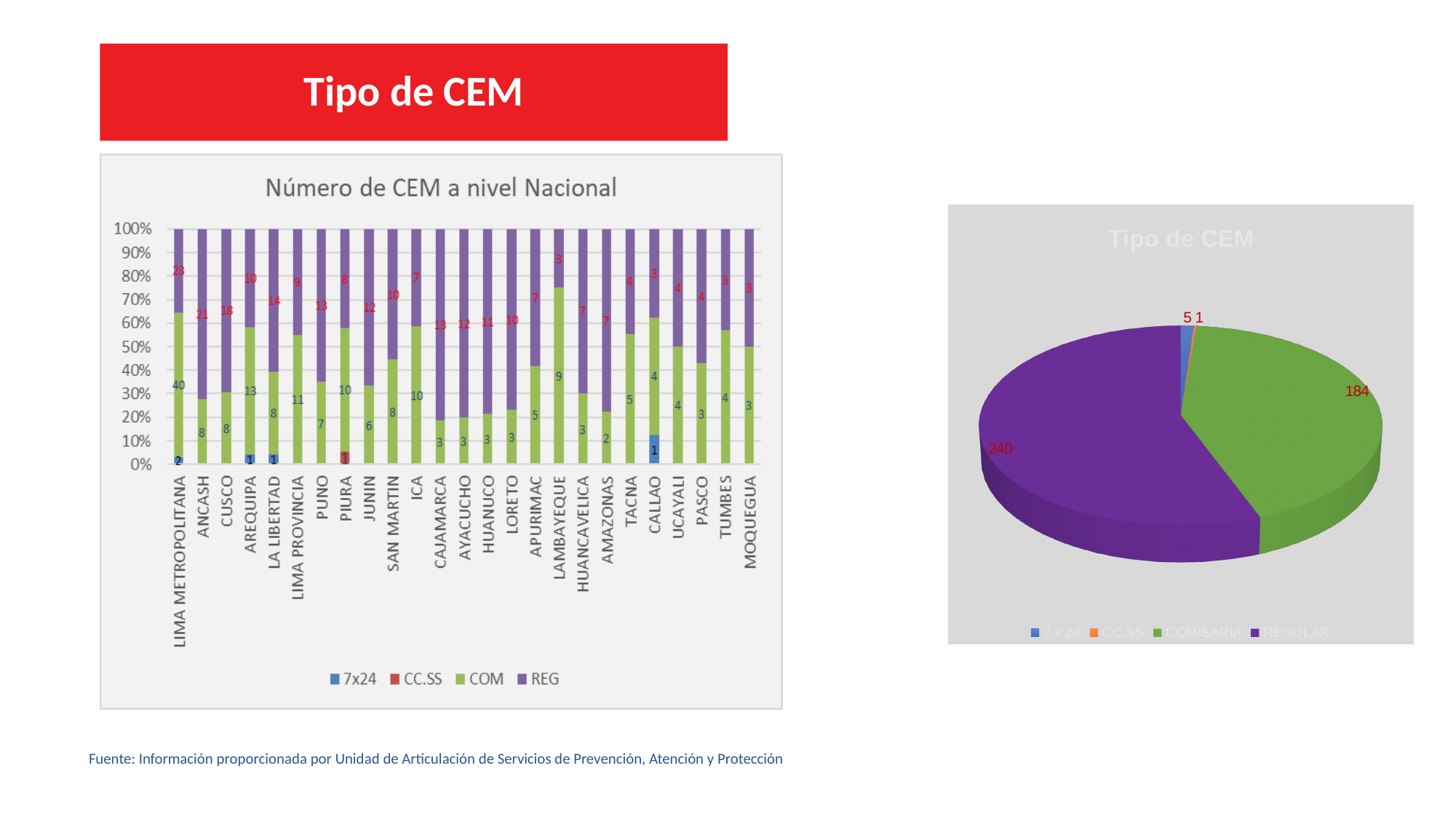
What kind of chart is the chart titled 'Tipo de CEM' on the right of the slide? Pie chart In the chart titled 'Número de CEM a nivel Nacional', how many categories are shown on the x axis? 25 In the chart titled 'Número de CEM a nivel Nacional', what is the REG value for Ancash? 21 In the chart titled 'Número de CEM a nivel Nacional', which category has the highest REG value? Lima Metropolitana In the chart titled 'Número de CEM a nivel Nacional', how many series does the legend list? 4 In the chart titled 'Número de CEM a nivel Nacional', what is the COM value for Lima Metropolitana? 40 In the chart titled 'Número de CEM a nivel Nacional', what is the difference between the REG value for Lima Metropolitana and the REG value for Ancash? 2 In the pie chart titled 'Tipo de CEM', which slice is the smallest? CC.SS In the chart titled 'Número de CEM a nivel Nacional', which is larger for Cusco, the COM value or the REG value? REG In the chart titled 'Número de CEM a nivel Nacional', what is the total of the stacked bar for Lima Metropolitana (7x24 + COM + REG)? 65 In the pie chart titled 'Tipo de CEM', what is the difference between the REGULAR value and the COMISARIA value? 56 In the pie chart titled 'Tipo de CEM', what is the value for REGULAR? 240